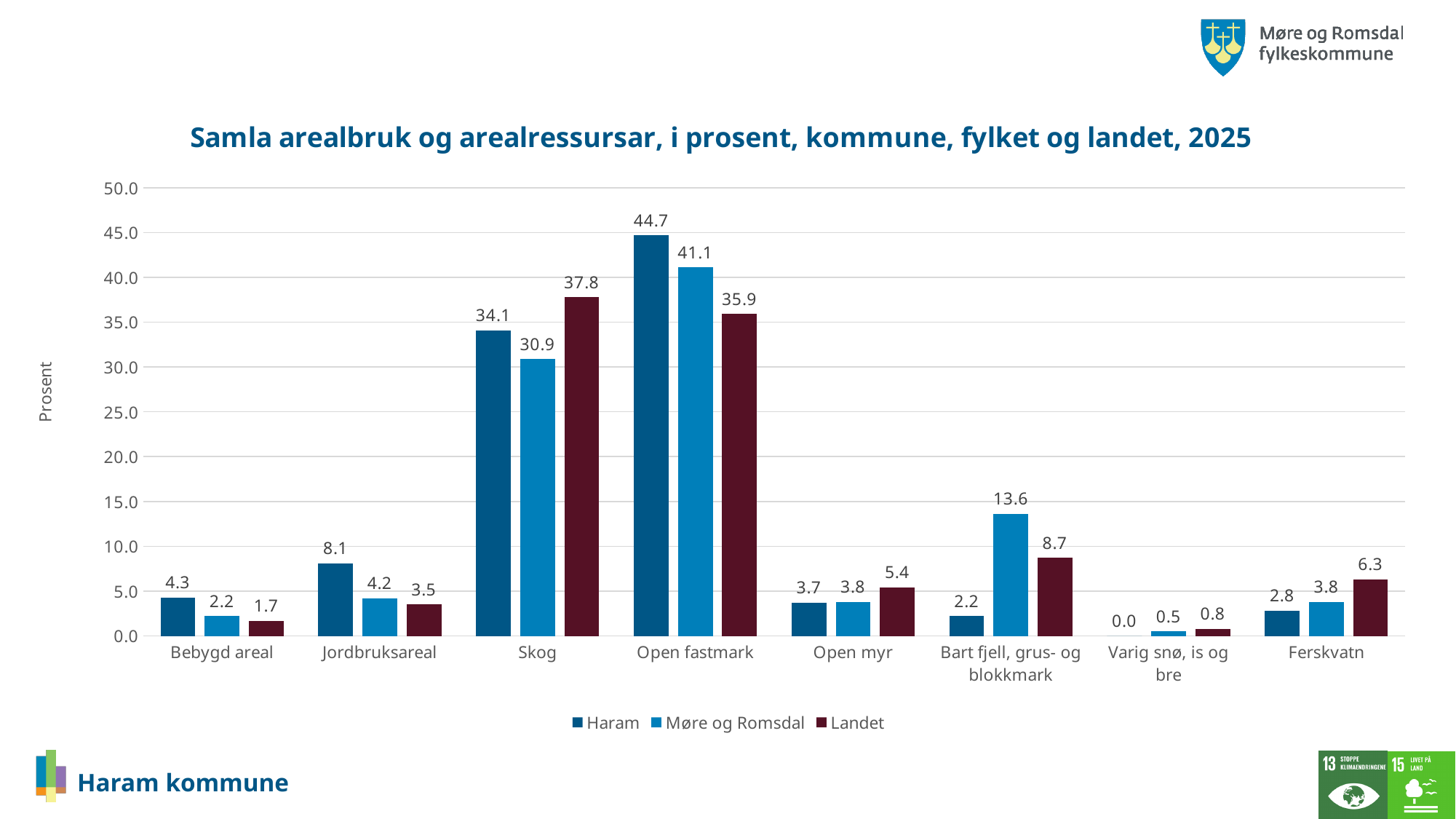
How many series does the legend list? 3 What is the value for Landet in the Open fastmark category? 35.9 How many categories are shown on the x axis? 8 Which category has the highest value for Haram? Open fastmark What is the title of the chart? Samla arealbruk og arealressursar, i prosent, kommune, fylket og landet, 2025 Which is larger for Skog: the value for Haram or the value for Landet? Landet What is the label on the y axis? Prosent What kind of chart is shown on the slide? Bar chart What is the value for Møre og Romsdal in the Bart fjell, grus- og blokkmark category? 13.6 What is the difference between the Haram and Landet values for Jordbruksareal? 4.6 Which category has the lowest value for Landet? Varig snø, is og bre What is the value for Haram in the Skog category? 34.1